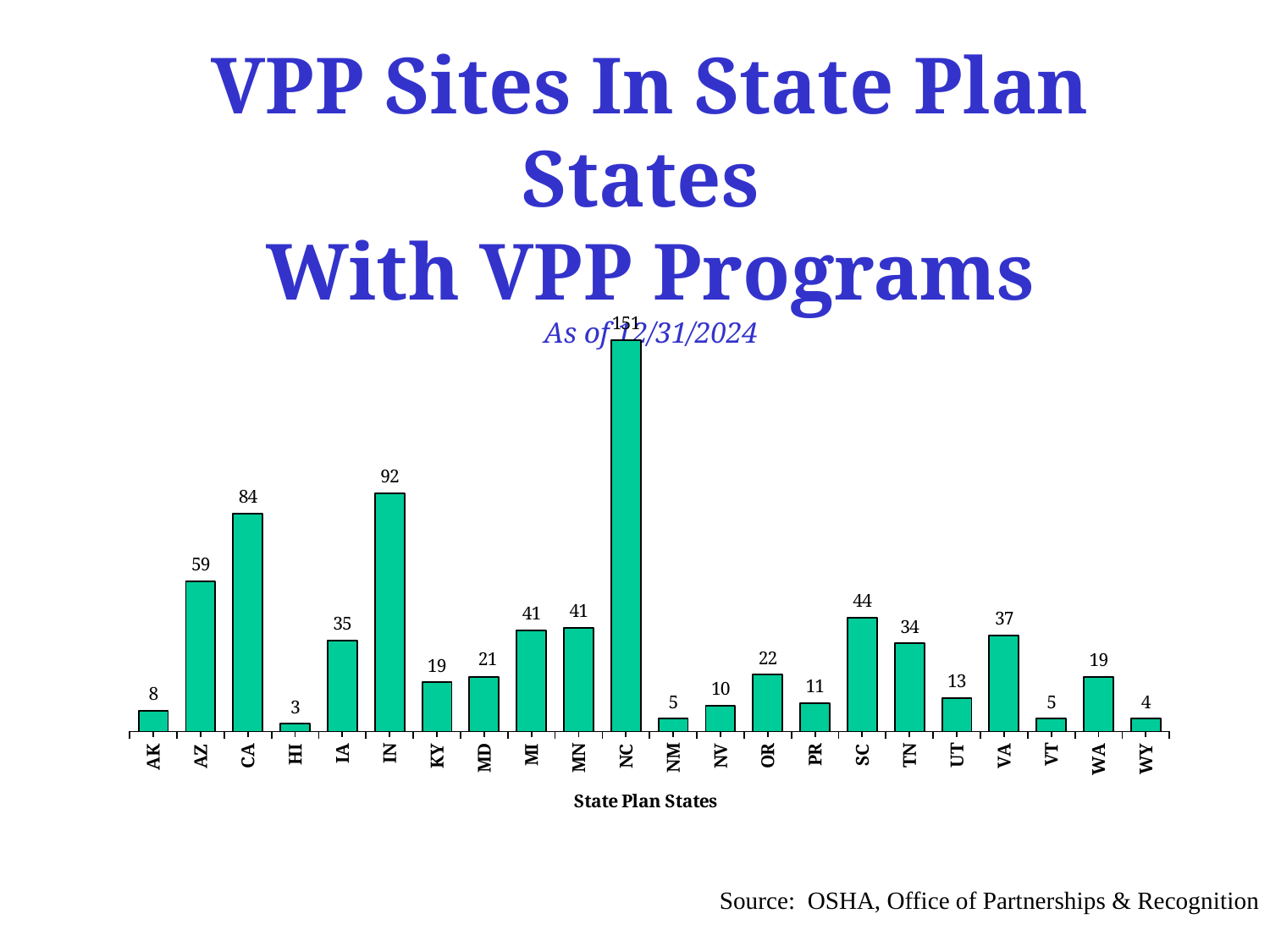
Which has more VPP sites, VA or TN? VA What kind of chart is shown on the slide? Bar chart What is the difference between the values for CA and AZ? 25 What is the difference between the values for IN and IA? 57 How many VPP sites does California (CA) have? 84 How many states are shown on the x axis? 22 How many VPP sites are shown for South Carolina (SC)? 44 Which state has the lowest number of VPP sites? HI What is the value shown for Indiana (IN)? 92 What is the x-axis title of the chart? State Plan States Which has more VPP sites, OR or KY? OR Which state has the highest number of VPP sites? NC